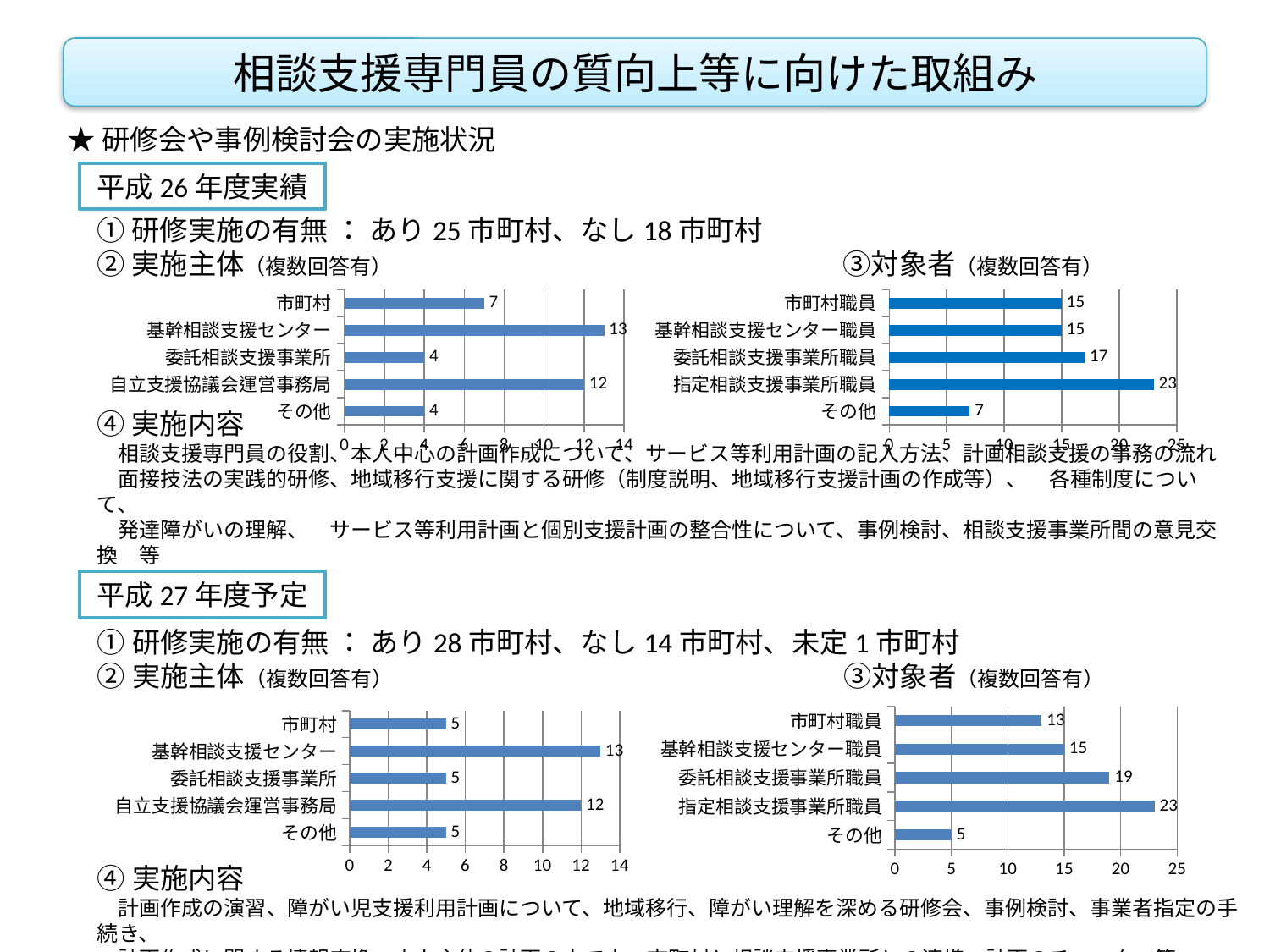
In the bottom-right chart (平成27年度予定 ③対象者), is the value for 指定相談支援事業所職員 greater or less than 20? greater In the top-right chart (平成26年度実績 ③対象者), how many categories are plotted? 5 In the bottom-right chart (平成27年度予定 ③対象者), what is the value for 委託相談支援事業所職員? 19 In the top-right chart (平成26年度実績 ③対象者), what is the value for 指定相談支援事業所職員? 23 In the top-right chart (平成26年度実績 ③対象者), which category has the lowest value? その他 What kind of chart is the top-left chart (平成26年度実績 ②実施主体)? bar chart In the top-left chart (平成26年度実績 ②実施主体), what is the value for 基幹相談支援センター? 13 In the bottom-left chart (平成27年度予定 ②実施主体), what is the value for 自立支援協議会運営事務局? 12 In the bottom-right chart (平成27年度予定 ③対象者), what is the difference between 指定相談支援事業所職員 and 市町村職員? 10 In the top-left chart (平成26年度実績 ②実施主体), what is the difference between 自立支援協議会運営事務局 and 市町村? 5 In the bottom-left chart (平成27年度予定 ②実施主体), which is larger, 基幹相談支援センター or 市町村? 基幹相談支援センター In the top-left chart (平成26年度実績 ②実施主体), which category has the highest value? 基幹相談支援センター